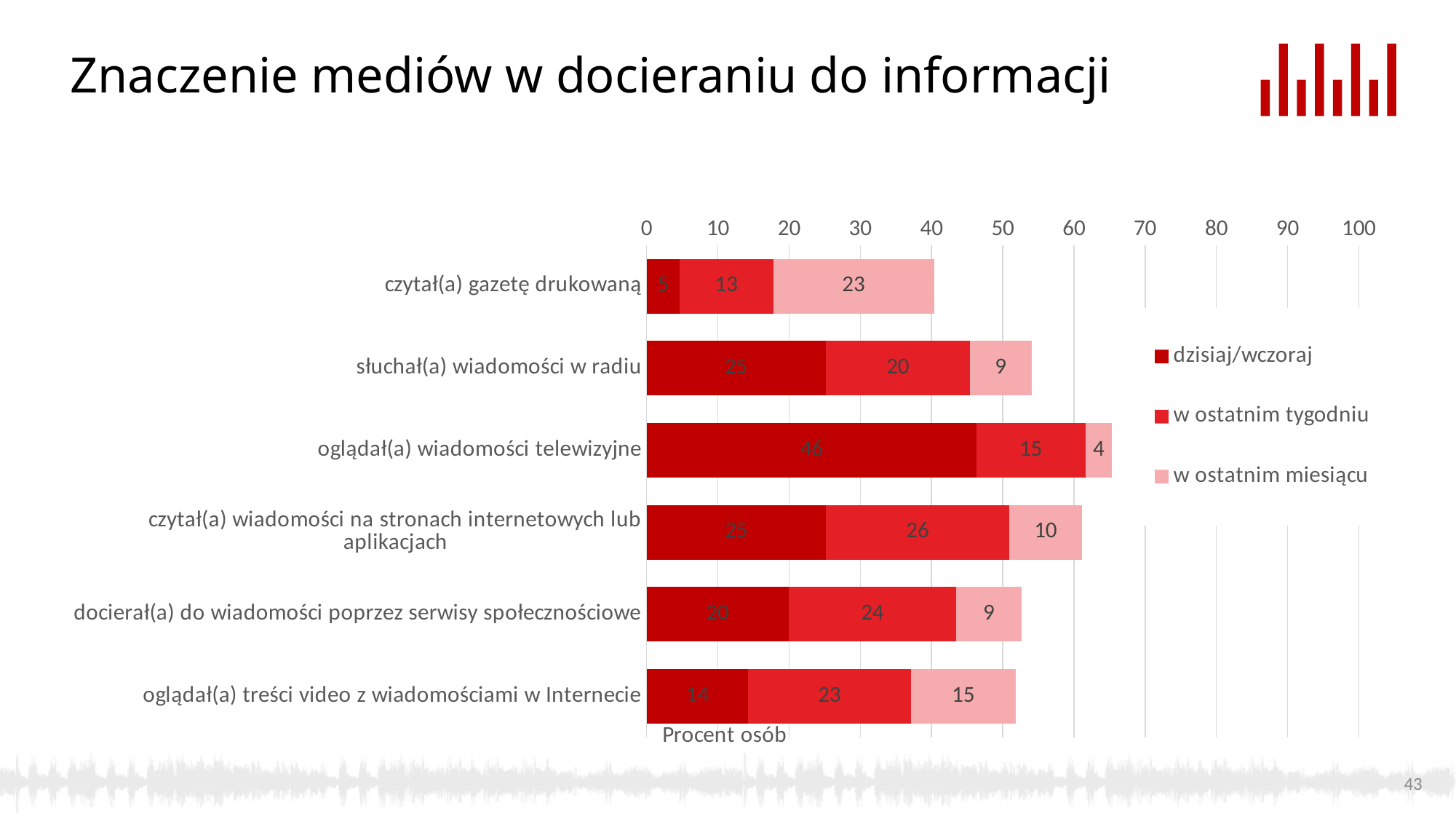
What is the label on the horizontal axis of the chart? Procent osób Which is larger: the 'w ostatnim tygodniu' value for 'czytał(a) wiadomości na stronach internetowych lub aplikacjach' or for 'oglądał(a) wiadomości telewizyjne'? czytał(a) wiadomości na stronach internetowych lub aplikacjach What is the total of the stacked bar for 'słuchał(a) wiadomości w radiu'? 54 How many series does the legend list? 3 What is the 'w ostatnim miesiącu' value for 'czytał(a) gazetę drukowaną'? 23 How many categories are plotted on the chart? 6 Which category has the highest 'dzisiaj/wczoraj' value? oglądał(a) wiadomości telewizyjne What is the difference between the 'dzisiaj/wczoraj' values for 'oglądał(a) wiadomości telewizyjne' and 'słuchał(a) wiadomości w radiu'? 21 Which category has the lowest 'dzisiaj/wczoraj' value? czytał(a) gazetę drukowaną What is the 'dzisiaj/wczoraj' value for 'oglądał(a) wiadomości telewizyjne'? 46 What is the 'w ostatnim tygodniu' value for 'docierał(a) do wiadomości poprzez serwisy społecznościowe'? 24 What kind of chart is shown on the slide? stacked bar chart